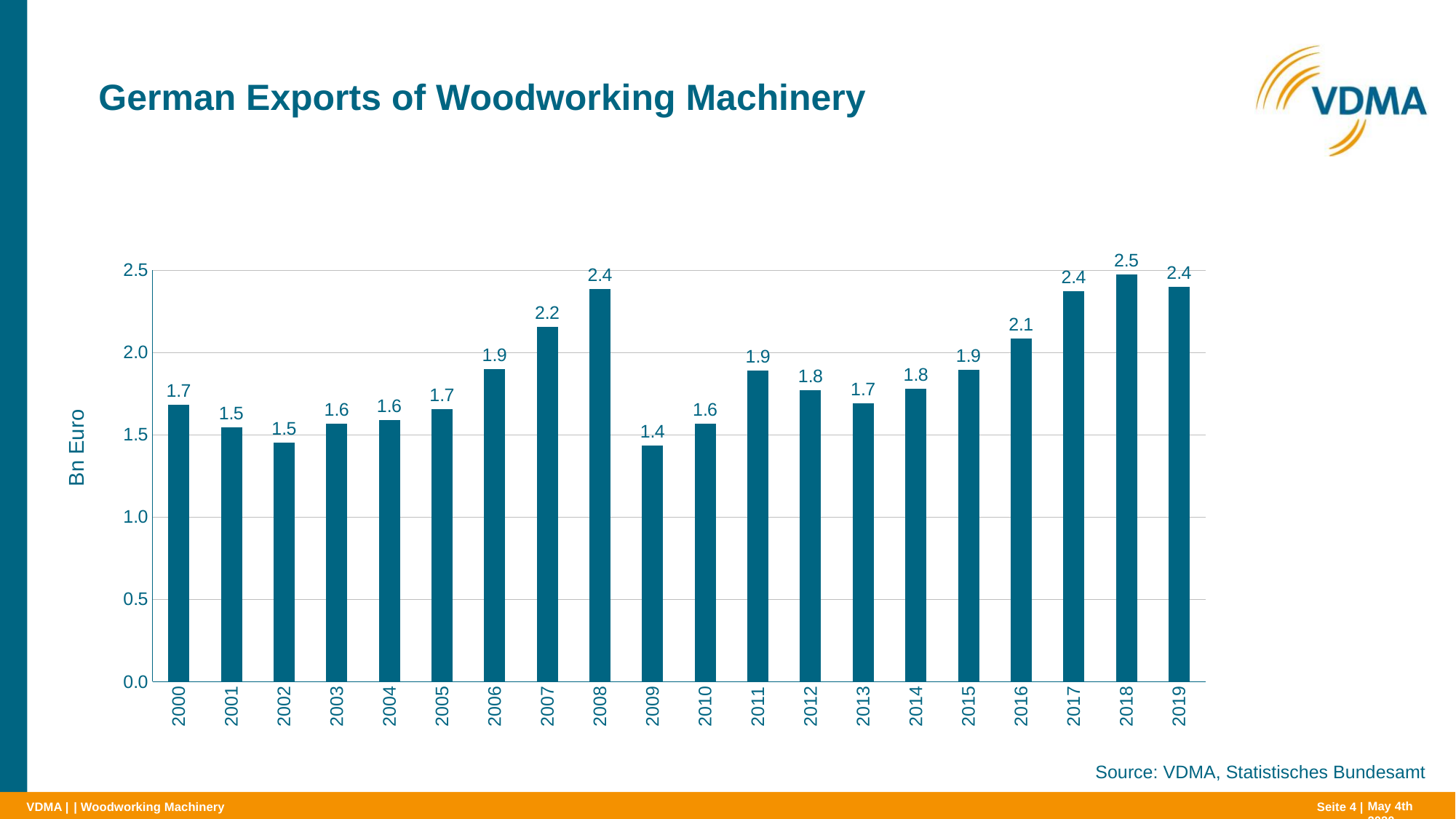
What value is shown for 2009? 1.4 Which year has the lowest value? 2009 Is the value for 2017 greater or less than 2.0? greater What is the label on the y axis? Bn Euro Which year has the highest value? 2018 How many years are shown on the x axis? 20 What is the difference between the values for 2008 and 2009? 1.0 What is the difference between the values for 2018 and 2000? 0.8 What was the value of German exports of woodworking machinery in 2008? 2.4 What kind of chart is shown on the slide? bar chart What value is shown for 2016? 2.1 Which year has the larger value, 2007 or 2011? 2007